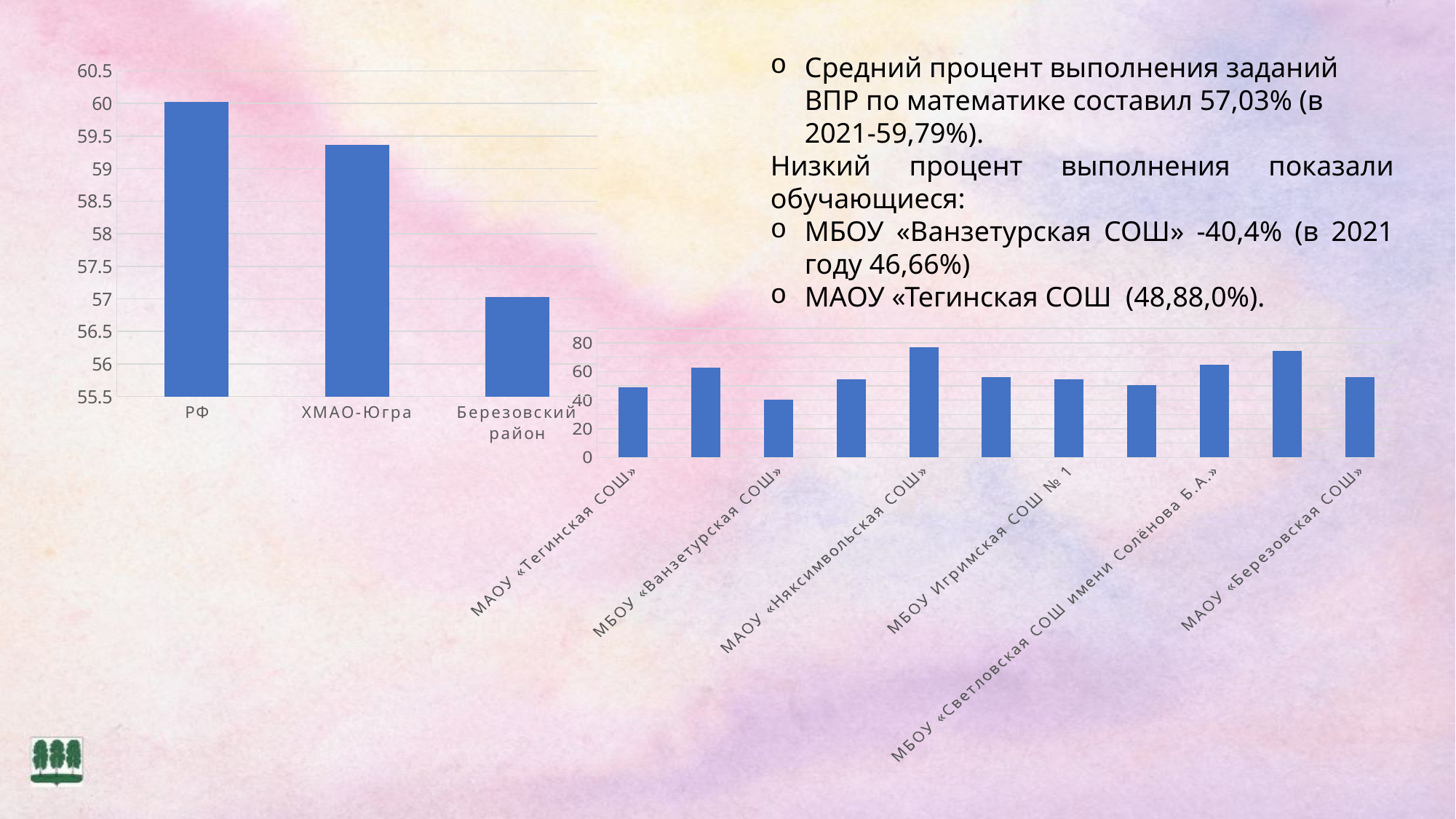
In the right chart of schools, which labelled school has the highest bar? МАОУ «Няксимвольская СОШ» In the left chart, which category has the lowest value? Березовский район In the left chart, which is larger: the value for РФ or for ХМАО-Югра? РФ How many bars are plotted in the right chart of schools? 11 How many categories are shown in the left chart? 3 In the left chart, which category has the highest value? РФ What kind of chart is the left chart comparing РФ, ХМАО-Югра and Березовский район? bar chart In the right chart of schools, which is larger: the value for МАОУ «Няксимвольская СОШ» or for МБОУ «Ванзетурская СОШ»? МАОУ «Няксимвольская СОШ» In the right chart of schools, is the value for МАОУ «Тегинская СОШ» greater or less than 60? less In the left chart, is the value for Березовский район greater or less than 58? less In the left chart, is the value for ХМАО-Югра greater or less than 59? greater In the right chart of schools, which school has the lowest bar? МБОУ «Ванзетурская СОШ»